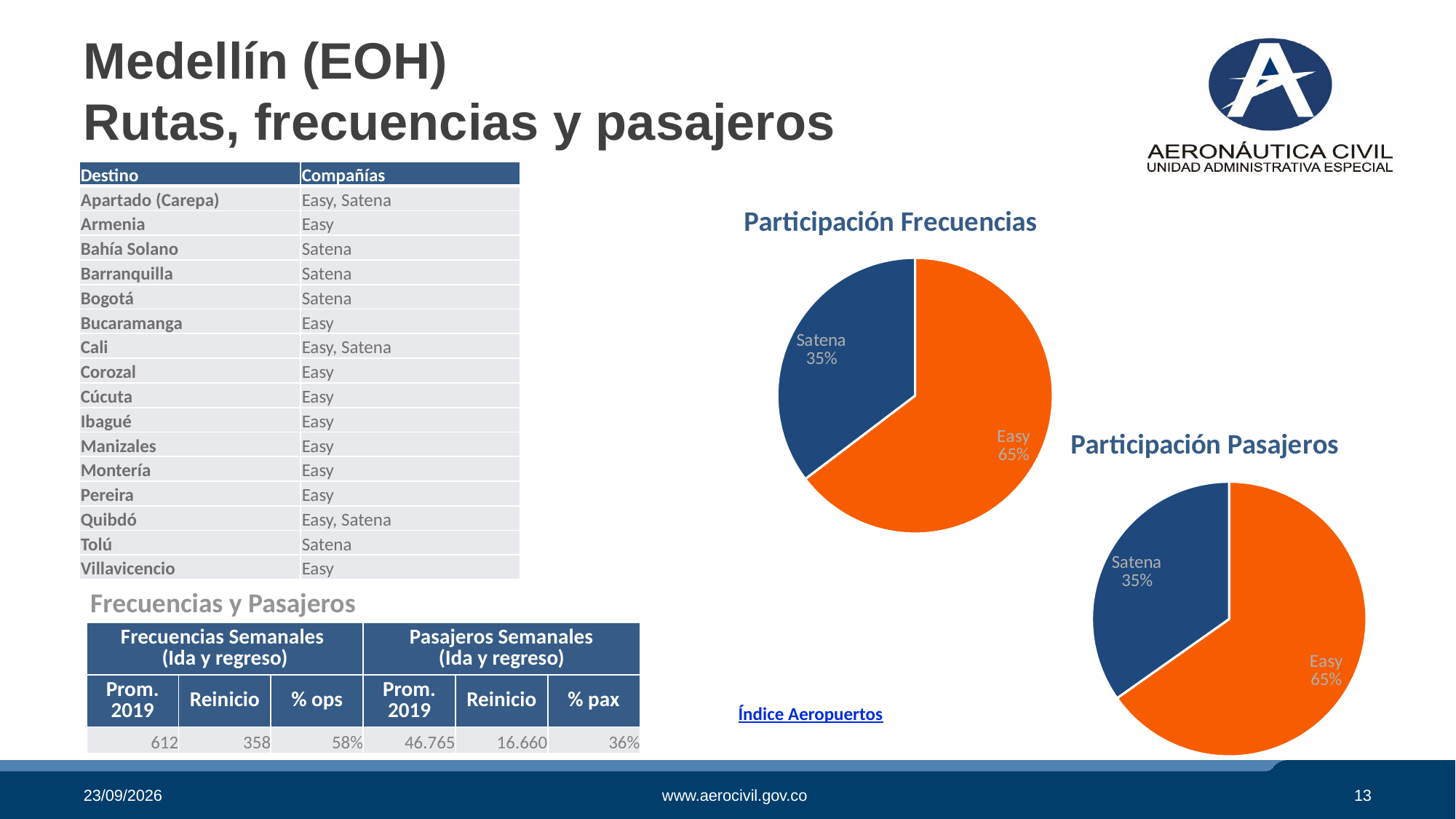
What is the title of the pie chart on the lower right of the slide? Participación Pasajeros In the 'Participación Frecuencias' chart, what is the difference between Easy's share and Satena's share? 30% In the 'Participación Frecuencias' chart, what colour is the Easy slice? Orange What kind of chart is 'Participación Frecuencias'? Pie chart How many slices does the 'Participación Pasajeros' chart have? 2 In the 'Participación Pasajeros' chart, which is larger, Easy's share or Satena's share? Easy In the 'Participación Pasajeros' chart, which company has the smallest slice? Satena In the 'Participación Pasajeros' chart, what share does Easy have? 65% In the 'Participación Frecuencias' chart, what share does Easy have? 65% In the 'Participación Frecuencias' chart, which company has the largest slice? Easy In the 'Participación Pasajeros' chart, what share does Satena have? 35% In the 'Participación Frecuencias' chart, what share does Satena have? 35%